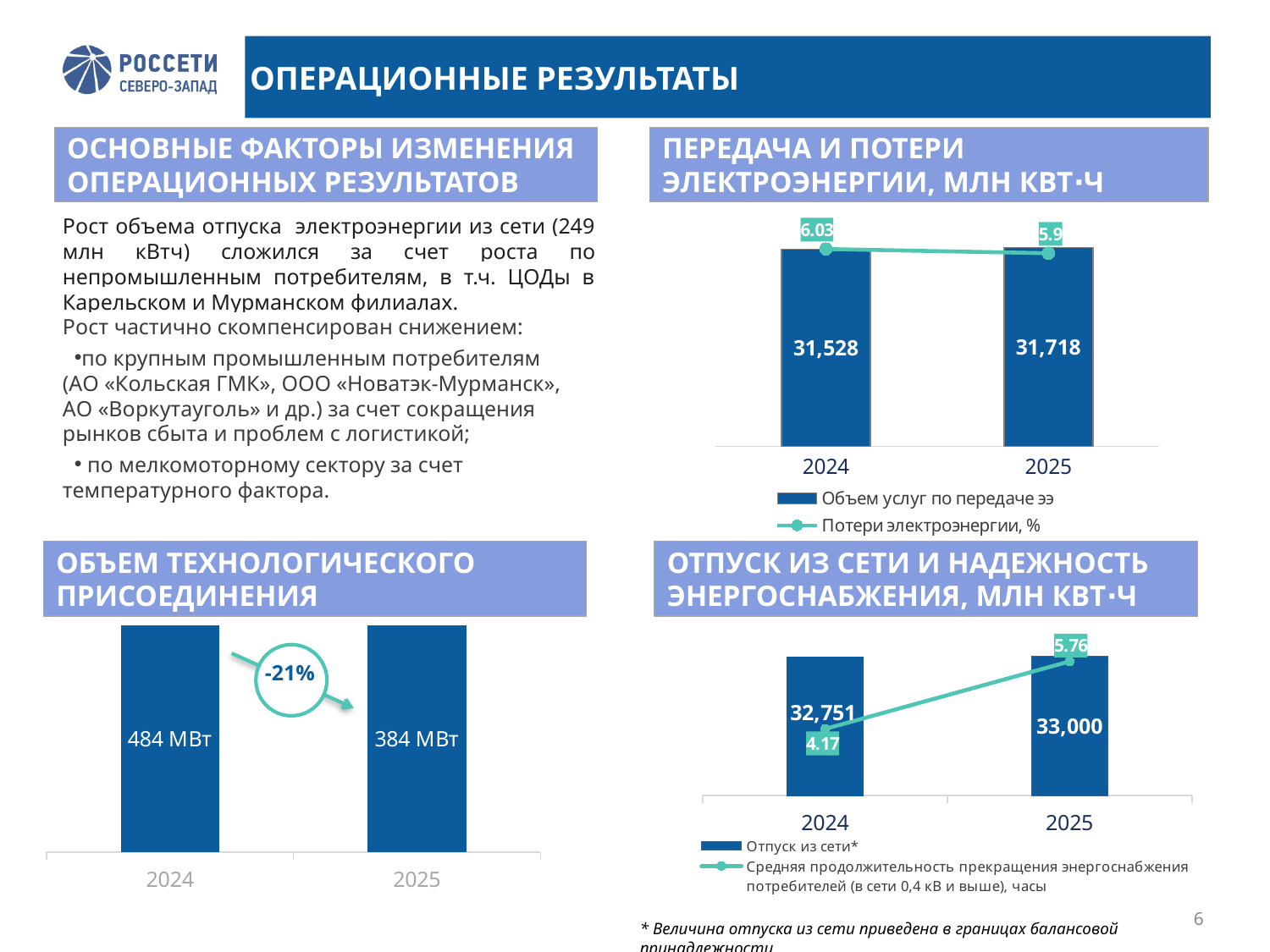
In the chart 'ПЕРЕДАЧА И ПОТЕРИ ЭЛЕКТРОЭНЕРГИИ, МЛН КВТ·Ч', what is the value of 'Потери электроэнергии, %' for 2025? 5.9 In the chart 'ПЕРЕДАЧА И ПОТЕРИ ЭЛЕКТРОЭНЕРГИИ, МЛН КВТ·Ч', does 'Потери электроэнергии, %' rise or fall from 2024 to 2025? fall In the chart 'ОТПУСК ИЗ СЕТИ И НАДЕЖНОСТЬ ЭНЕРГОСНАБЖЕНИЯ, МЛН КВТ·Ч', what is the value of 'Отпуск из сети*' for 2025? 33,000 In the chart 'ПЕРЕДАЧА И ПОТЕРИ ЭЛЕКТРОЭНЕРГИИ, МЛН КВТ·Ч', what is the value of 'Объем услуг по передаче ээ' for 2024? 31,528 In the chart 'ПЕРЕДАЧА И ПОТЕРИ ЭЛЕКТРОЭНЕРГИИ, МЛН КВТ·Ч', what is the difference between the 2025 and 2024 values of 'Объем услуг по передаче ээ'? 190 In the chart 'ОБЪЕМ ТЕХНОЛОГИЧЕСКОГО ПРИСОЕДИНЕНИЯ', what percentage change is shown between 2024 and 2025? -21% How many series does the legend of the chart 'ПЕРЕДАЧА И ПОТЕРИ ЭЛЕКТРОЭНЕРГИИ, МЛН КВТ·Ч' list? 2 In the chart 'ОТПУСК ИЗ СЕТИ И НАДЕЖНОСТЬ ЭНЕРГОСНАБЖЕНИЯ, МЛН КВТ·Ч', what is the value of the line series for 2024? 4.17 In the chart 'ОБЪЕМ ТЕХНОЛОГИЧЕСКОГО ПРИСОЕДИНЕНИЯ', what is the value for 2025? 384 МВт In the chart 'ОТПУСК ИЗ СЕТИ И НАДЕЖНОСТЬ ЭНЕРГОСНАБЖЕНИЯ, МЛН КВТ·Ч', which year has the larger value of 'Отпуск из сети*', 2024 or 2025? 2025 What kind of chart is 'ОБЪЕМ ТЕХНОЛОГИЧЕСКОГО ПРИСОЕДИНЕНИЯ'? bar chart In the chart 'ОБЪЕМ ТЕХНОЛОГИЧЕСКОГО ПРИСОЕДИНЕНИЯ', which year has the higher value? 2024